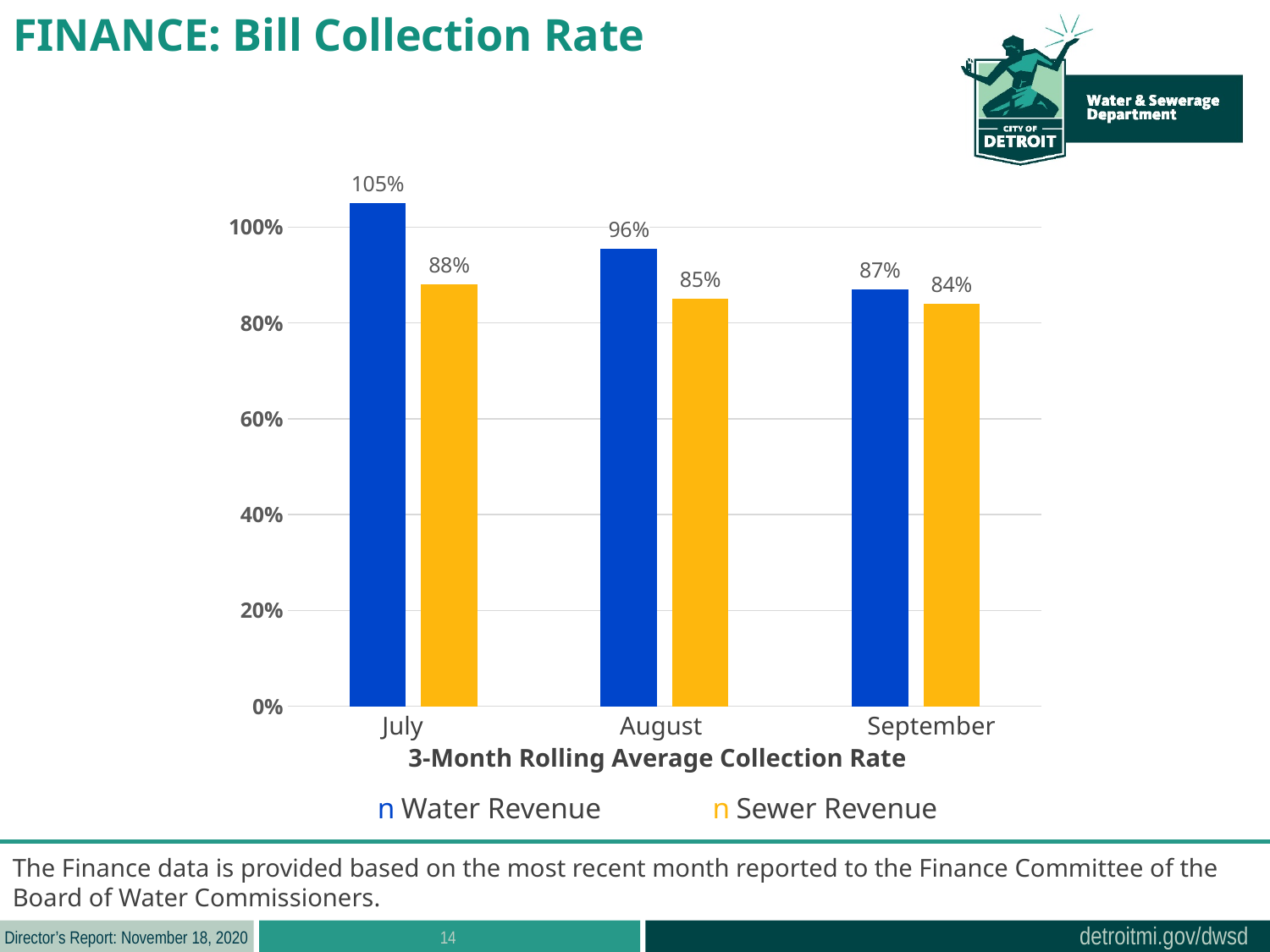
Does the Water Revenue collection rate rise or fall from July to September? Fall What is the difference between the Water Revenue collection rates for July and September? 18% What is the Sewer Revenue collection rate for August? 85% How many months are shown on the x axis? 3 What is the Water Revenue collection rate for July? 105% Which month has the lowest Sewer Revenue collection rate? September Which month has the highest Water Revenue collection rate? July Which is larger in August, the Water Revenue or the Sewer Revenue collection rate? Water Revenue What kind of chart is shown on the slide? Bar chart What is the difference between the Water Revenue and Sewer Revenue collection rates in July? 17% How many series does the legend list? 2 What is the Sewer Revenue collection rate for September? 84%